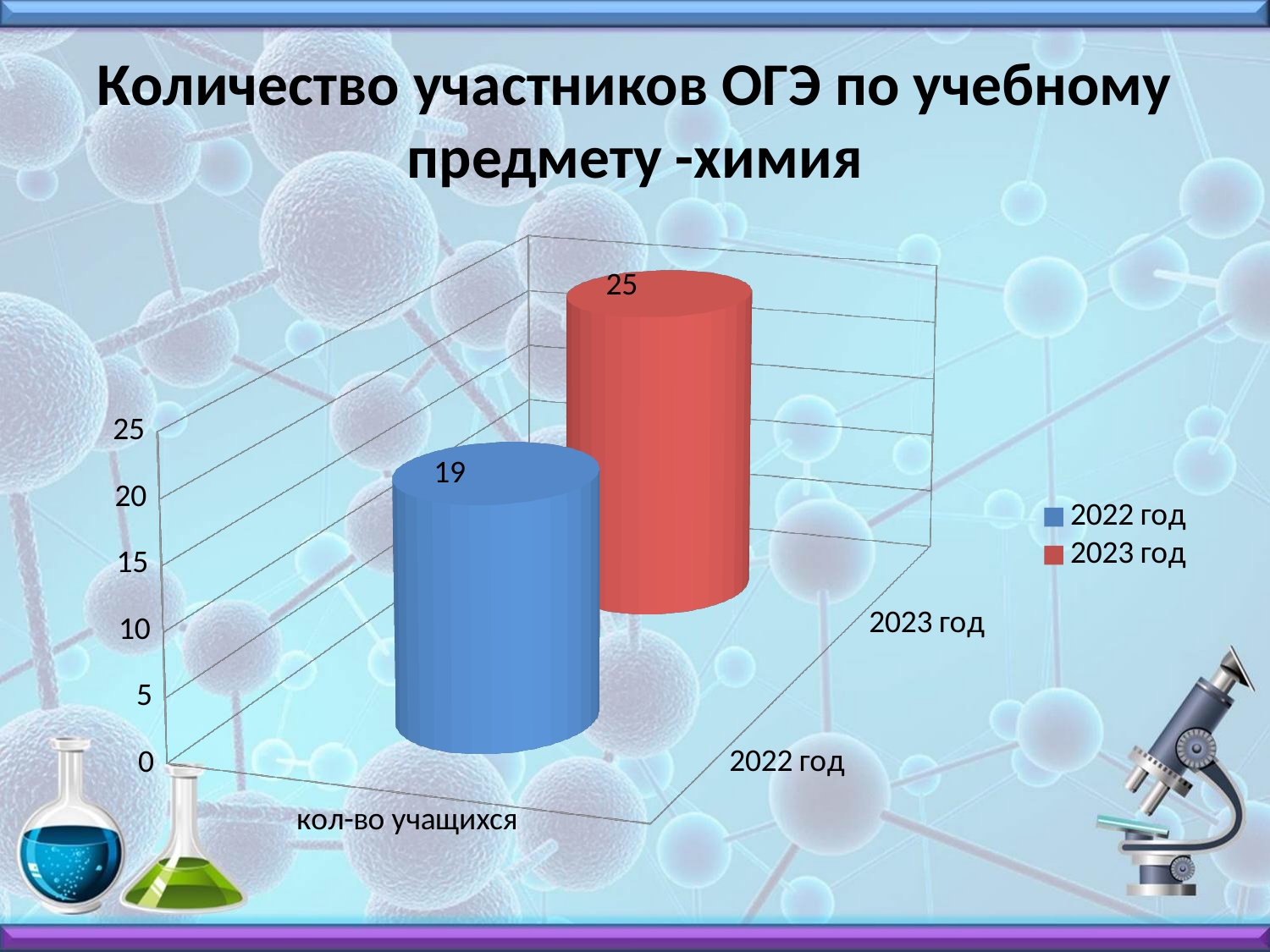
What is the value for 2023 год? 25 Which year has the lower number of participants? 2022 год Which year has the higher number of participants? 2023 год What colour is the bar for 2023 год? red What is the value for 2022 год? 19 How many series does the legend list? 2 Is the value for 2023 год greater or less than 20? greater Do the values rise or fall from 2022 год to 2023 год? rise Is the value for 2022 год greater or less than 20? less What is the title of the chart on the slide? Количество участников ОГЭ по учебному предмету -химия What kind of chart is shown on the slide? bar chart What is the difference between the values for 2023 год and 2022 год? 6